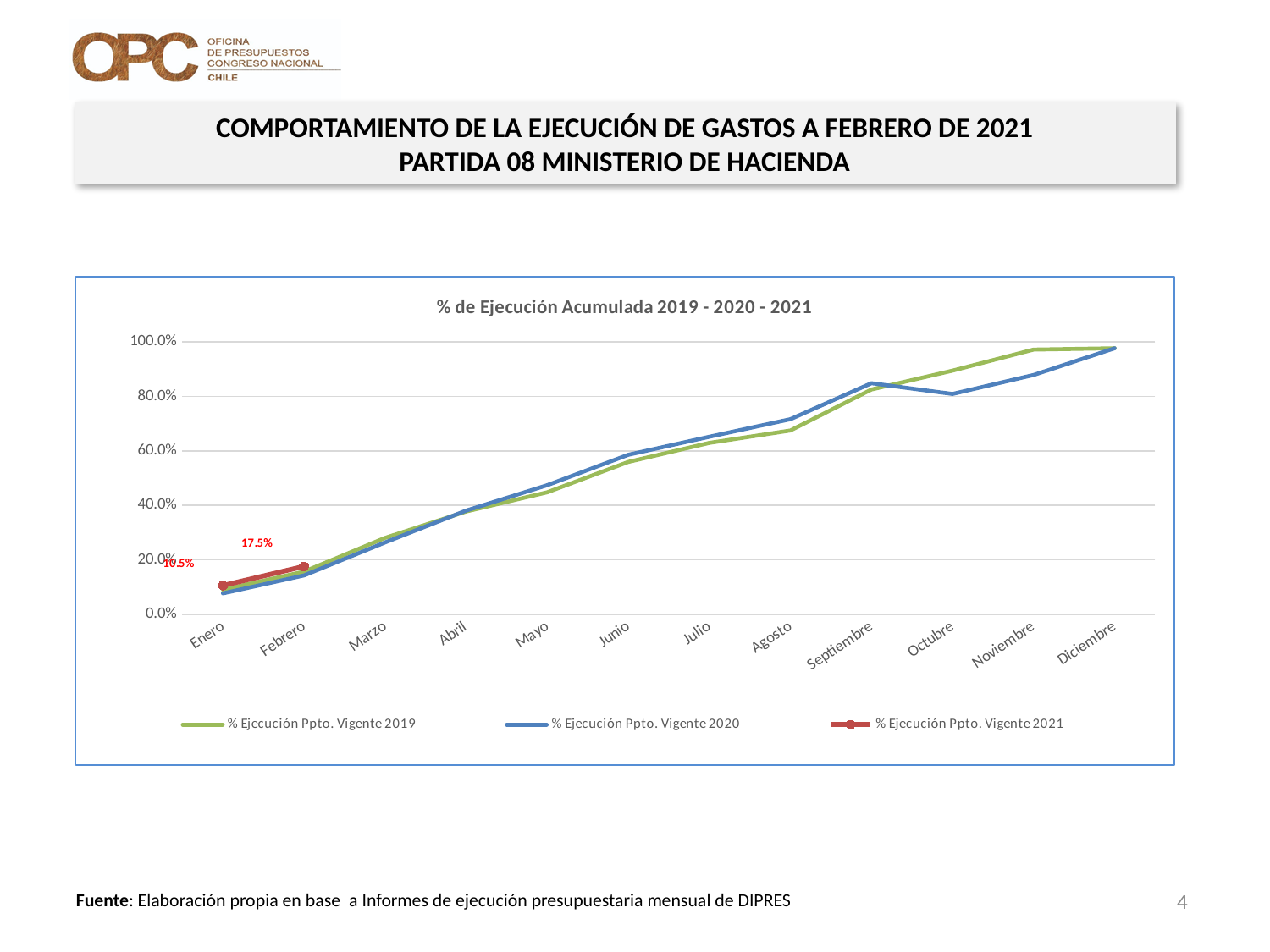
Is the value for Noviembre in the % Ejecución Ppto. Vigente 2019 series greater or less than 80.0%? greater How many series does the legend list? 3 How many months are shown on the x axis? 12 For Noviembre, which series has the larger value: % Ejecución Ppto. Vigente 2019 or % Ejecución Ppto. Vigente 2020? % Ejecución Ppto. Vigente 2019 Which month has the highest value in the % Ejecución Ppto. Vigente 2021 series? Febrero What is the difference between the Febrero and Enero values of the % Ejecución Ppto. Vigente 2021 series? 7.0% What is the value for Enero in the % Ejecución Ppto. Vigente 2021 series? 10.5% What kind of chart is shown on the slide? Line chart Is the value for Abril in the % Ejecución Ppto. Vigente 2020 series greater or less than 40.0%? less Do the values of the % Ejecución Ppto. Vigente 2019 series rise or fall from Enero to Diciembre? Rise What is the title of the chart? % de Ejecución Acumulada 2019 - 2020 - 2021 What is the value for Febrero in the % Ejecución Ppto. Vigente 2021 series? 17.5%